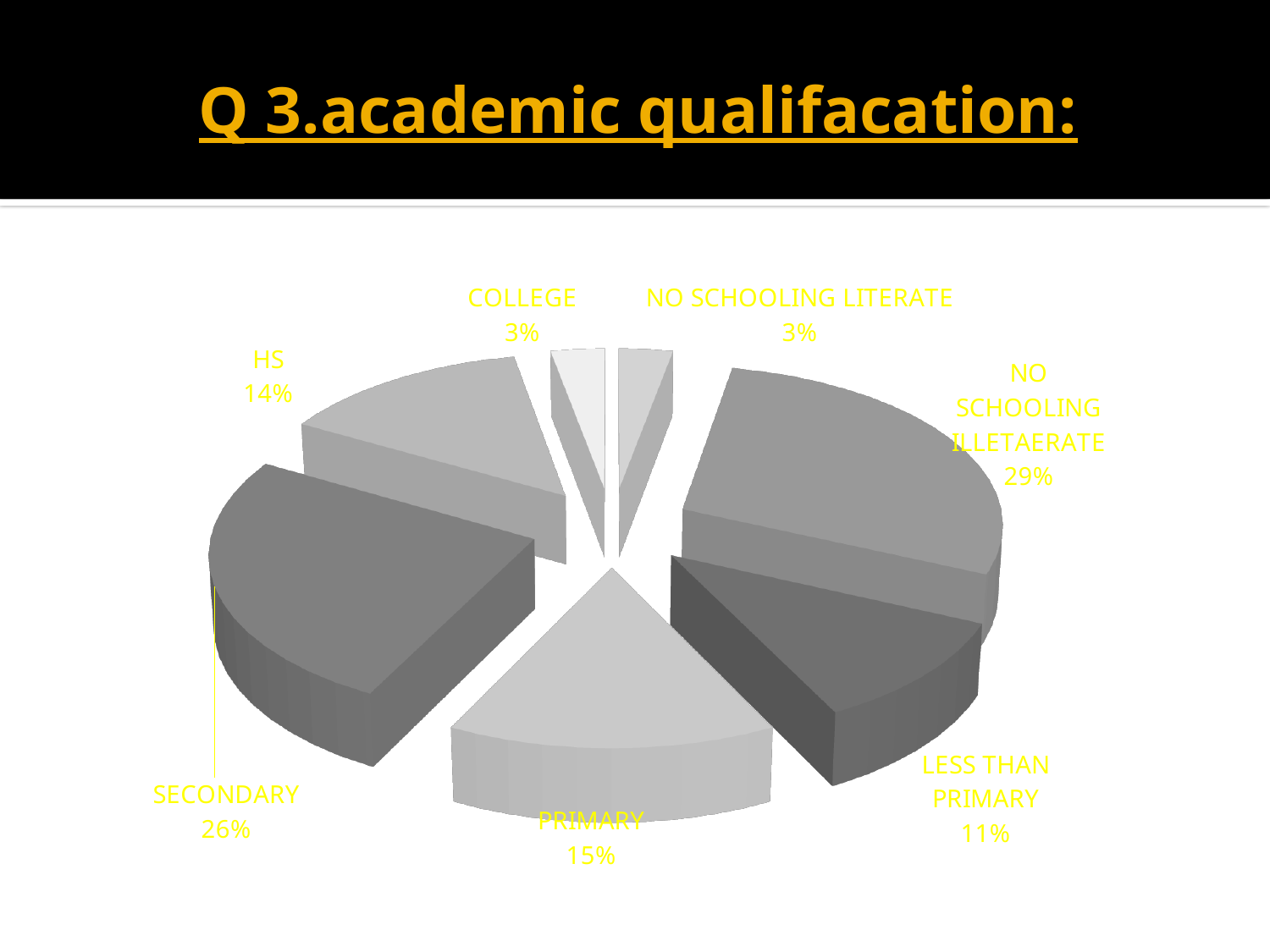
What percentage is shown for NO SCHOOLING ILLETAERATE? 29% What percentage is shown for LESS THAN PRIMARY? 11% What is the difference in percentage points between SECONDARY and HS? 12 What is the difference in percentage points between NO SCHOOLING ILLETAERATE and SECONDARY? 3 Which is larger, the share for PRIMARY or the share for LESS THAN PRIMARY? PRIMARY What is the title of the slide containing the pie chart? Q 3.academic qualifacation: What kind of chart is shown on the slide? Pie chart What share of the pie does SECONDARY represent? 26% What percentage is shown for PRIMARY? 15% How many slices does the pie chart have? 7 What percentage is shown for HS? 14% Which category has the largest share of the pie? NO SCHOOLING ILLETAERATE